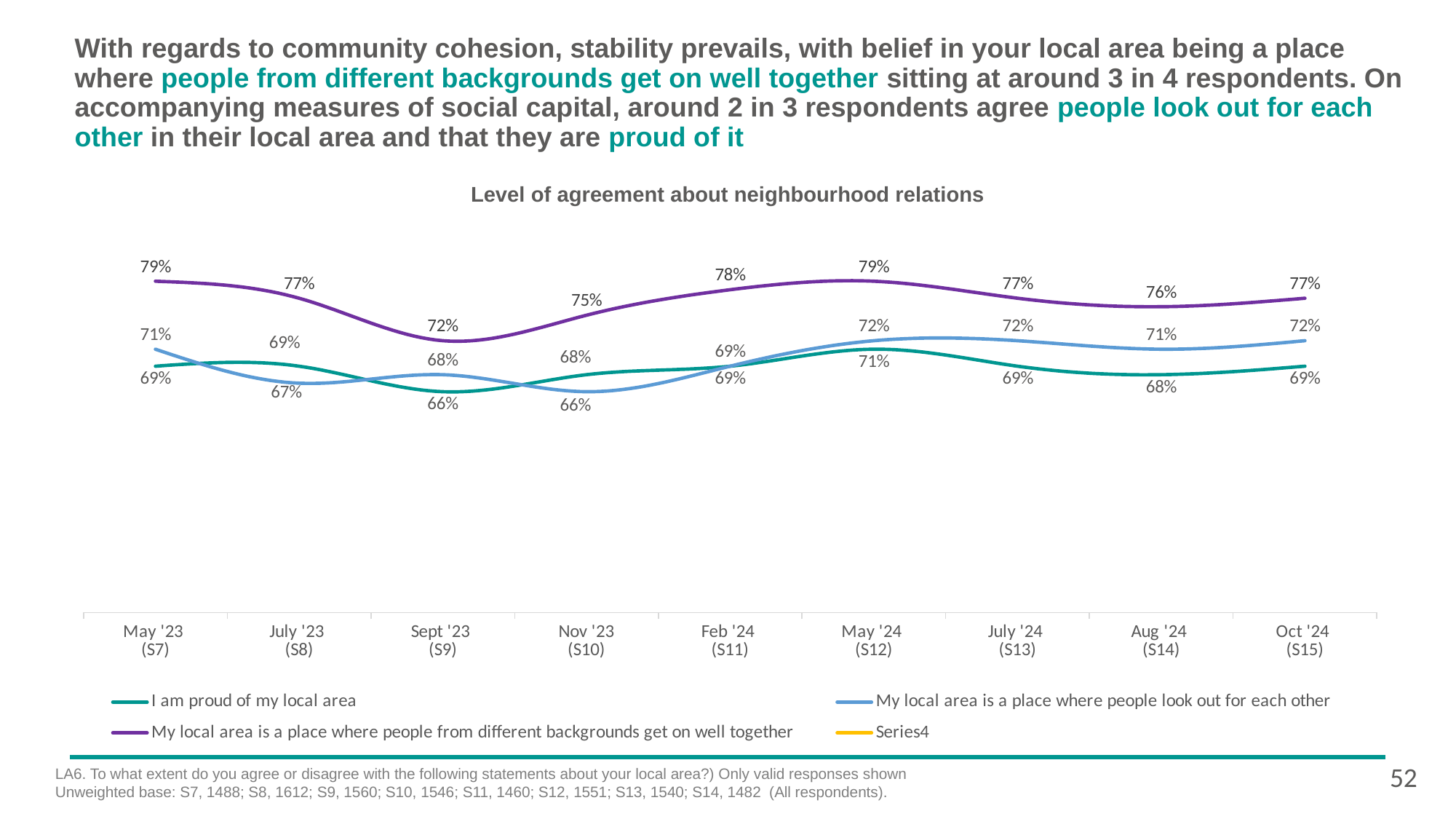
What is the title of the chart? Level of agreement about neighbourhood relations At Nov '23 (S10), which is higher: "I am proud of my local area" or "My local area is a place where people look out for each other"? I am proud of my local area How many survey waves are shown on the x axis? 9 What is the value for "My local area is a place where people look out for each other" at Oct '24 (S15)? 72% How many series does the legend list? 4 At Oct '24 (S15), what is the difference between "My local area is a place where people from different backgrounds get on well together" and "I am proud of my local area"? 8 percentage points At which survey wave is the value for "I am proud of my local area" highest? May '24 (S12) What kind of chart is shown on the slide? Line chart What is the value for "My local area is a place where people from different backgrounds get on well together" at May '23 (S7)? 79% At which survey wave is the value for "My local area is a place where people from different backgrounds get on well together" lowest? Sept '23 (S9) What is the value for "I am proud of my local area" at Sept '23 (S9)? 66% Between Sept '23 (S9) and May '24 (S12), does the value for "My local area is a place where people from different backgrounds get on well together" rise or fall? Rise